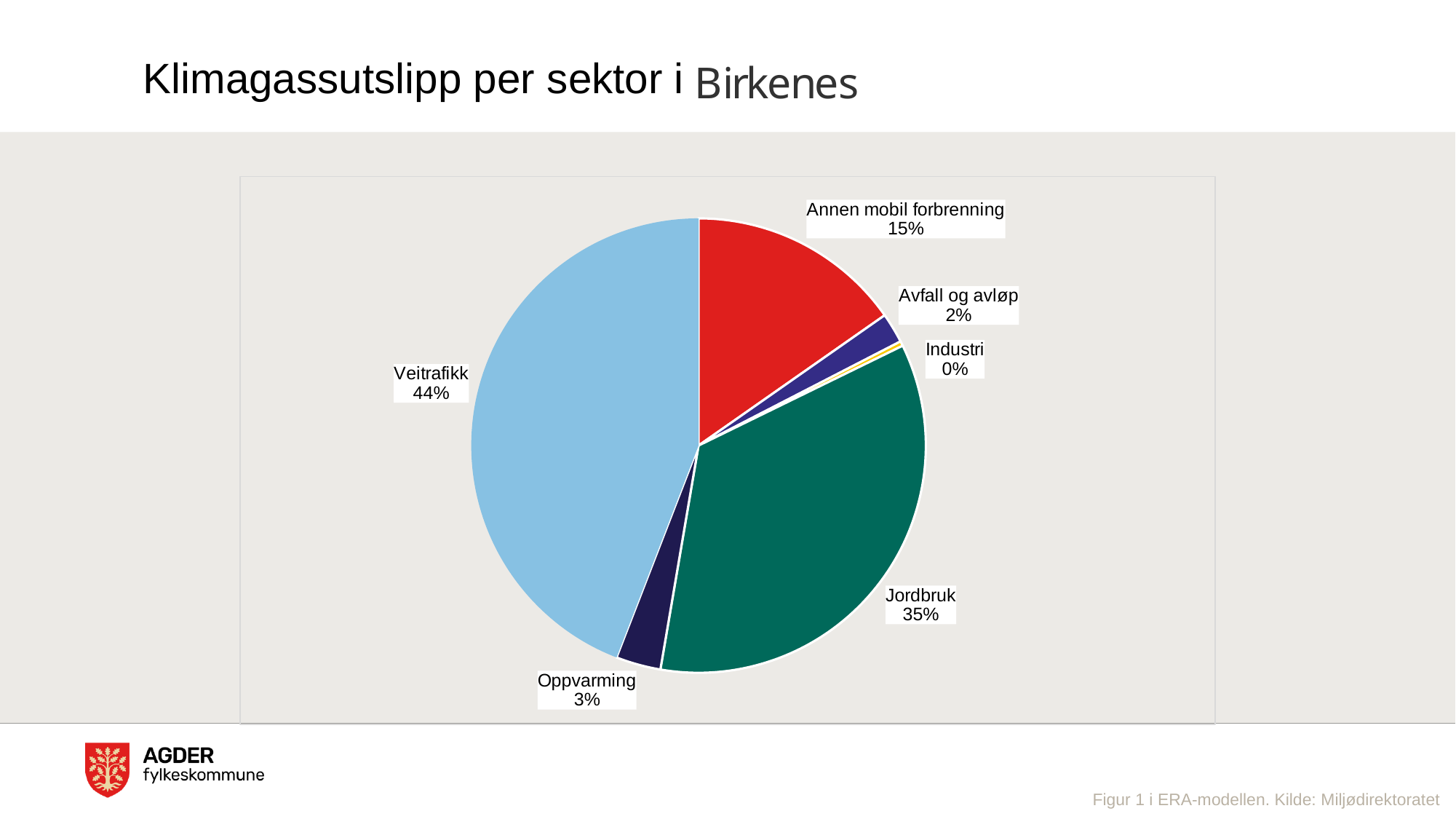
What is the value shown for Industri? 0% What is the value shown for Avfall og avløp? 2% What is the value shown for Oppvarming? 3% Which sector has the smallest share of the pie? Industri Which is larger, Annen mobil forbrenning or Oppvarming? Annen mobil forbrenning What is the value shown for Annen mobil forbrenning? 15% What share of the pie does Jordbruk have? 35% Which sector has the largest share of the pie? Veitrafikk What is the difference in percentage points between Veitrafikk and Jordbruk? 9 What kind of chart is shown on the slide? Pie chart How many sectors are shown in the pie chart? 6 What share of the pie does Veitrafikk have? 44%